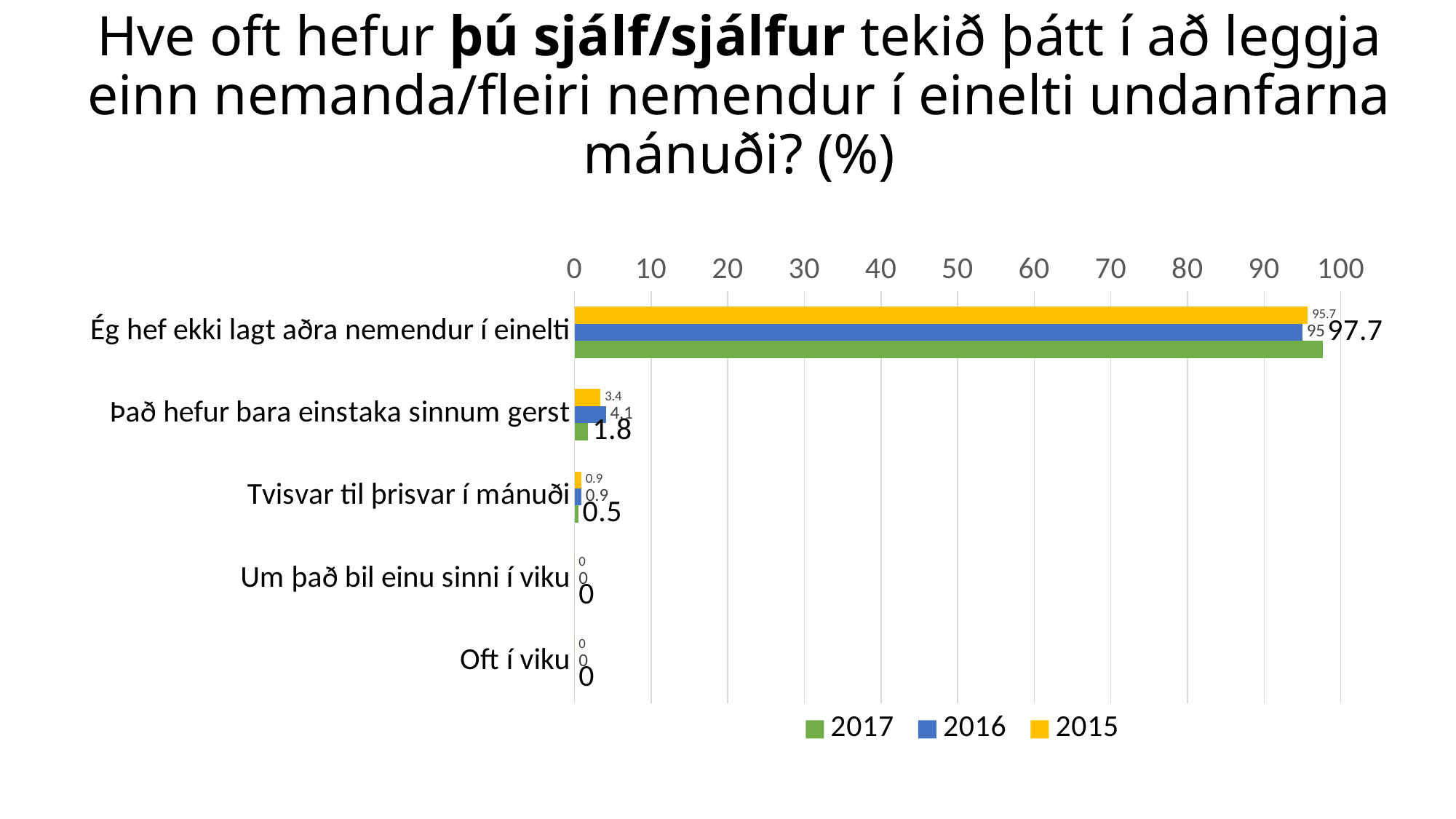
What type of chart is shown on the slide? bar chart What is the difference between the 2017 and 2016 values for "Ég hef ekki lagt aðra nemendur í einelti"? 2.7 Which colour represents the 2015 series in the legend? yellow How many series does the legend list? 3 Is the 2016 value for "Ég hef ekki lagt aðra nemendur í einelti" greater or less than 90? greater What is the 2017 value for "Tvisvar til þrisvar í mánuði"? 0.5 What is the 2016 value for "Það hefur bara einstaka sinnum gerst"? 4.1 What is the 2017 value for "Ég hef ekki lagt aðra nemendur í einelti"? 97.7 How many categories are shown on the chart? 5 What is the 2015 value for "Ég hef ekki lagt aðra nemendur í einelti"? 95.7 Which is larger for "Það hefur bara einstaka sinnum gerst": the 2015 value or the 2016 value? 2016 Which category has the highest value for 2017? Ég hef ekki lagt aðra nemendur í einelti